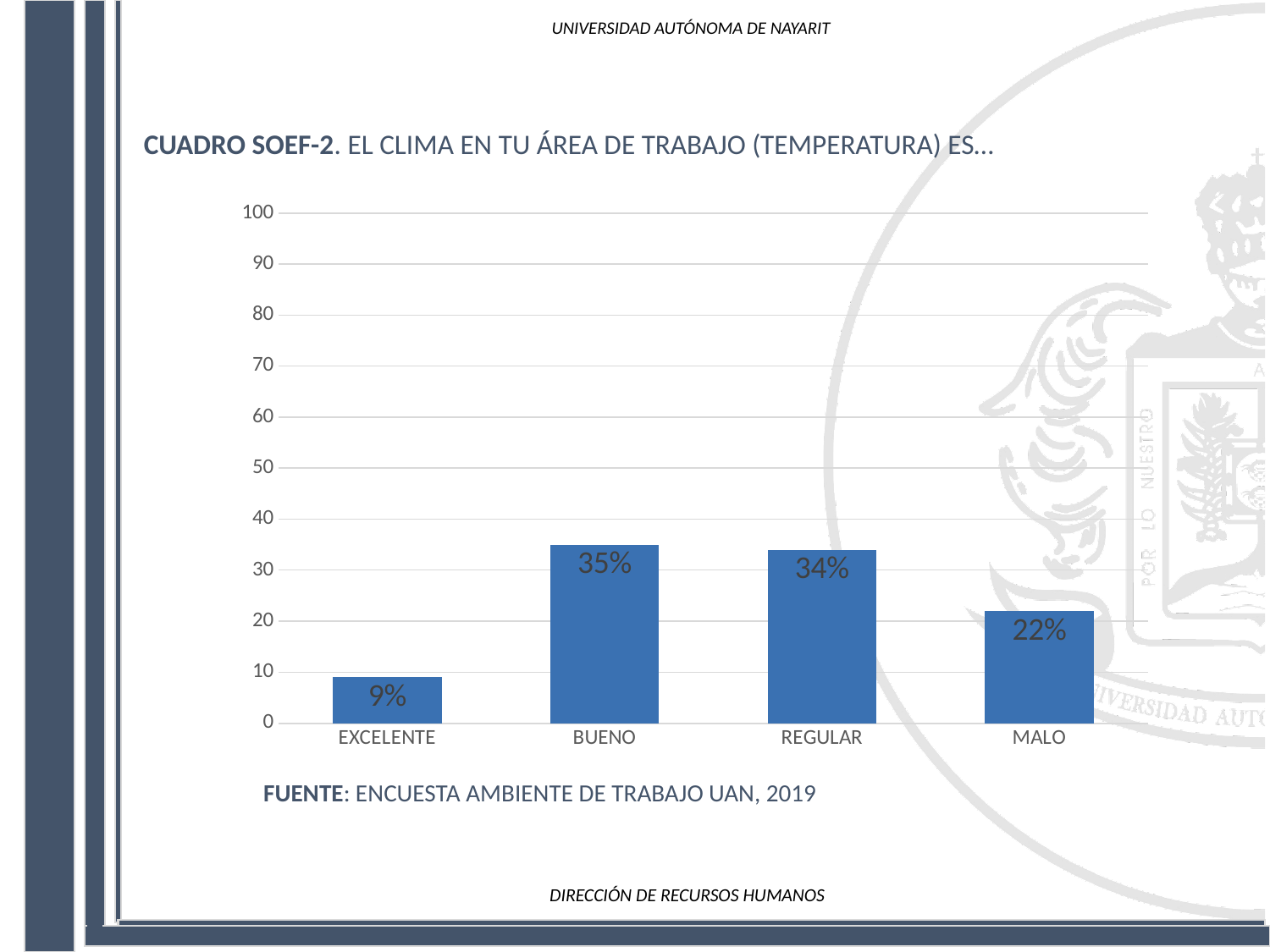
Which is larger, the value for MALO or the value for EXCELENTE? MALO What is the value for MALO? 22% What source is cited below the chart? ENCUESTA AMBIENTE DE TRABAJO UAN, 2019 Is the value for REGULAR greater or less than 40? less What is the value for EXCELENTE? 9% What is the value for REGULAR? 34% What is the difference between the values for BUENO and MALO? 13% How many categories are shown on the x axis? 4 Which category has the lowest value? EXCELENTE What is the value for BUENO? 35% Which category has the highest value? BUENO What kind of chart is shown on the slide? bar chart